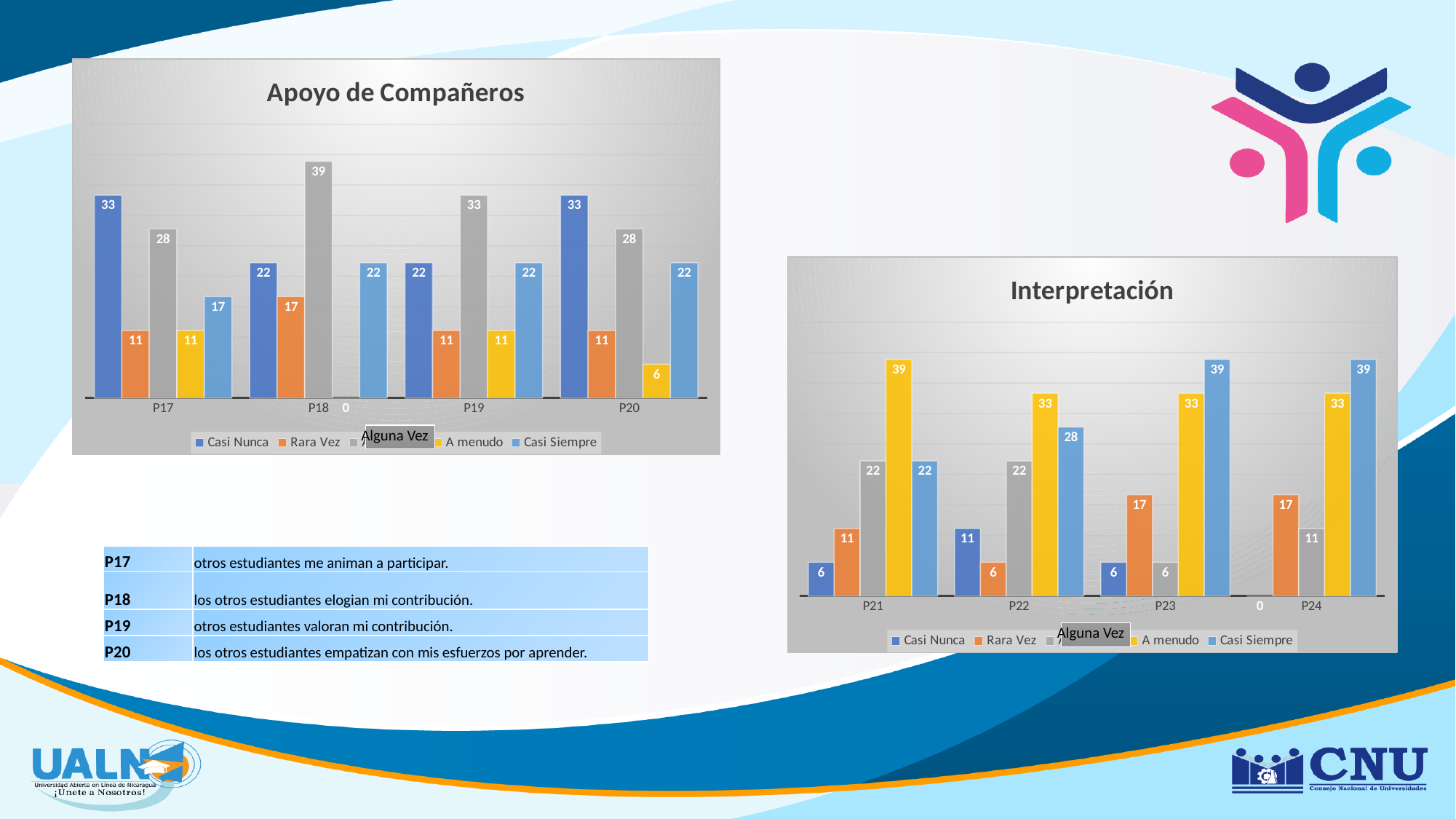
How many categories are shown on the x axis of the 'Interpretación' chart? 4 In the 'Apoyo de Compañeros' chart, what is the difference between Casi Nunca and Rara Vez for P17? 22 In the 'Apoyo de Compañeros' chart, which series has the highest value for P19? Alguna Vez How many series does the legend of the 'Apoyo de Compañeros' chart list? 5 In the 'Interpretación' chart, which series has the lowest value for P22? Rara Vez What kind of chart is the 'Interpretación' chart? Bar chart In the 'Apoyo de Compañeros' chart, what is the value of A menudo for P20? 6 In the 'Apoyo de Compañeros' chart, what is the value of Casi Nunca for P17? 33 In the 'Apoyo de Compañeros' chart, what is the value of Alguna Vez for P18? 39 In the 'Interpretación' chart, what is the value of A menudo for P21? 39 In the 'Interpretación' chart, is the Casi Siempre value for P23 larger or smaller than the A menudo value for P23? larger In the 'Interpretación' chart, what is the value of Casi Siempre for P22? 28